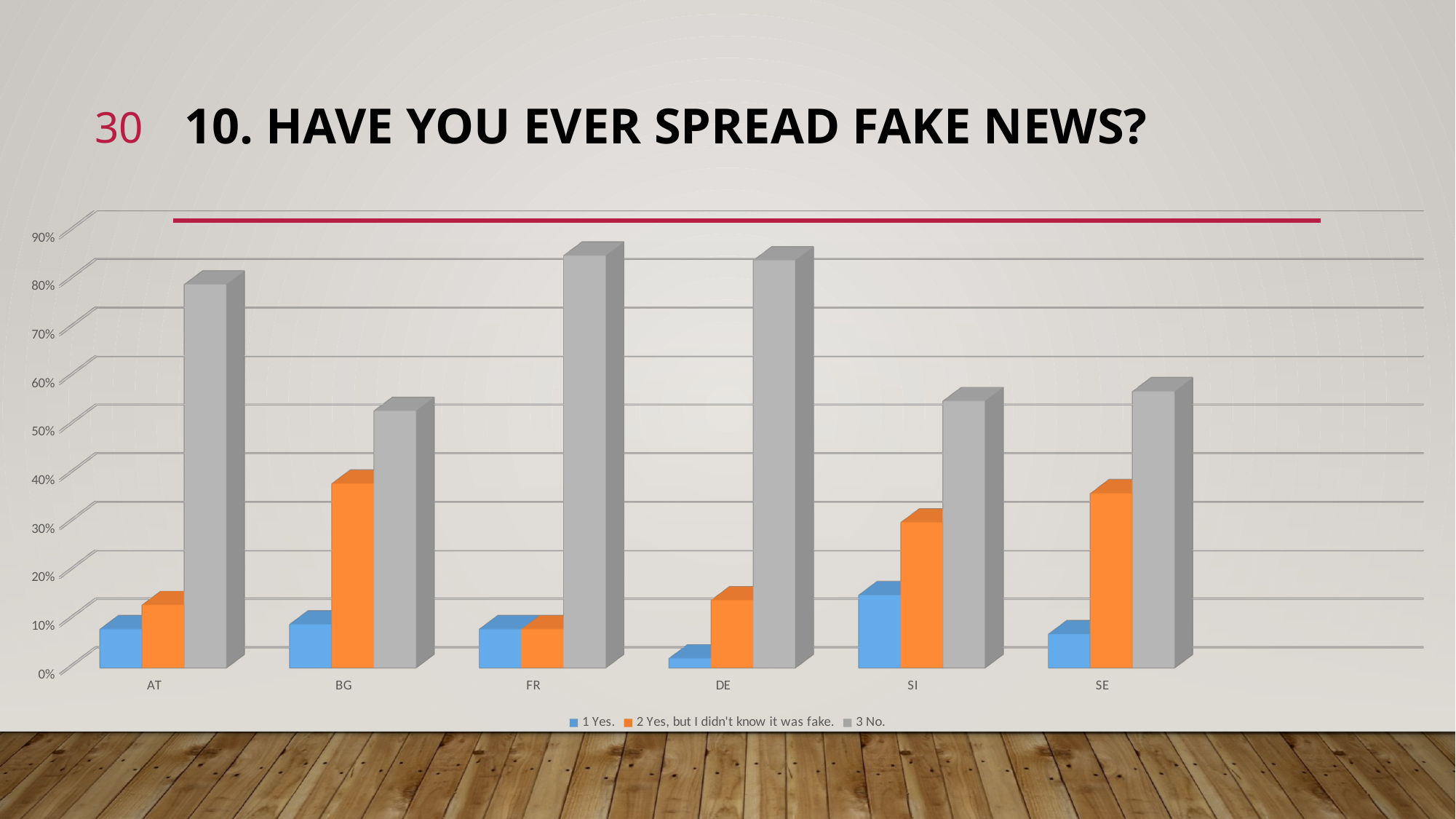
Is the '1 Yes.' value for DE greater or less than 10%? less Which country has the lowest value for the '2 Yes, but I didn't know it was fake.' series? FR Which is larger: the '3 No.' value for AT or for SI? AT What kind of chart is shown on the slide? bar chart Which country has the lowest value for the '1 Yes.' series? DE How many countries (categories) are shown on the x axis? 6 Is the '2 Yes, but I didn't know it was fake.' value for BG greater or less than 30%? greater What is the title of the chart on the slide? 10. HAVE YOU EVER SPREAD FAKE NEWS? Is the '3 No.' value for AT greater or less than 70%? greater Which country has the highest value for the '1 Yes.' series? SI How many series does the legend list? 3